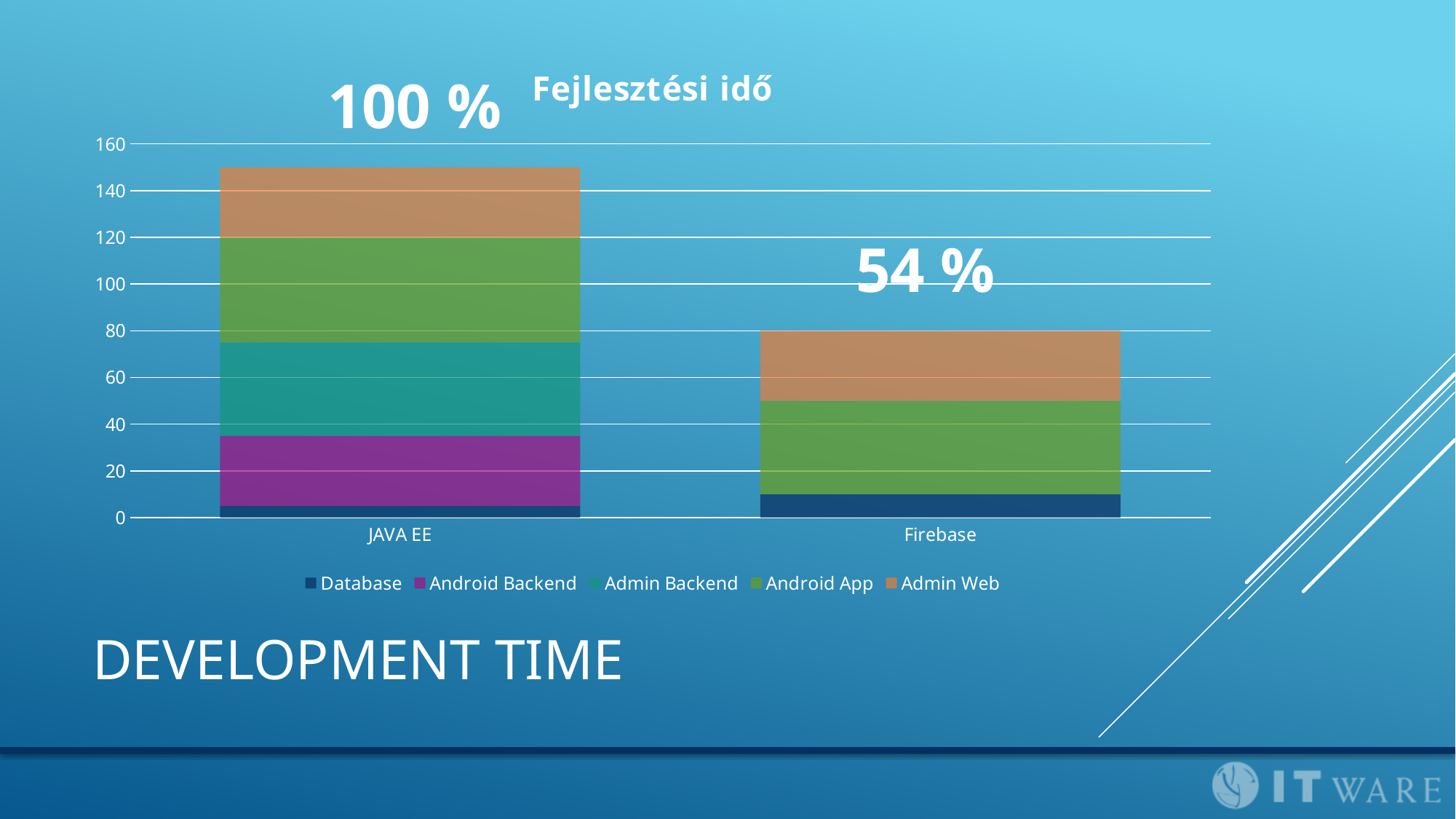
Which series appears in the JAVA EE bar but not in the Firebase bar? Android Backend and Admin Backend Which category has the taller stacked bar, JAVA EE or Firebase? JAVA EE What is the title of the chart? Fejlesztési idő How many categories are shown on the x axis of the chart? 2 Which category has the lowest total development time? Firebase What kind of chart is shown on the slide? Stacked bar chart What percentage label is shown above the JAVA EE bar? 100 % Is the total for JAVA EE greater or less than 140? greater How many series does the chart legend list? 5 Is the total for Firebase greater or less than 100? less What percentage label is shown above the Firebase bar? 54 % Is the total for JAVA EE greater or less than 160? less